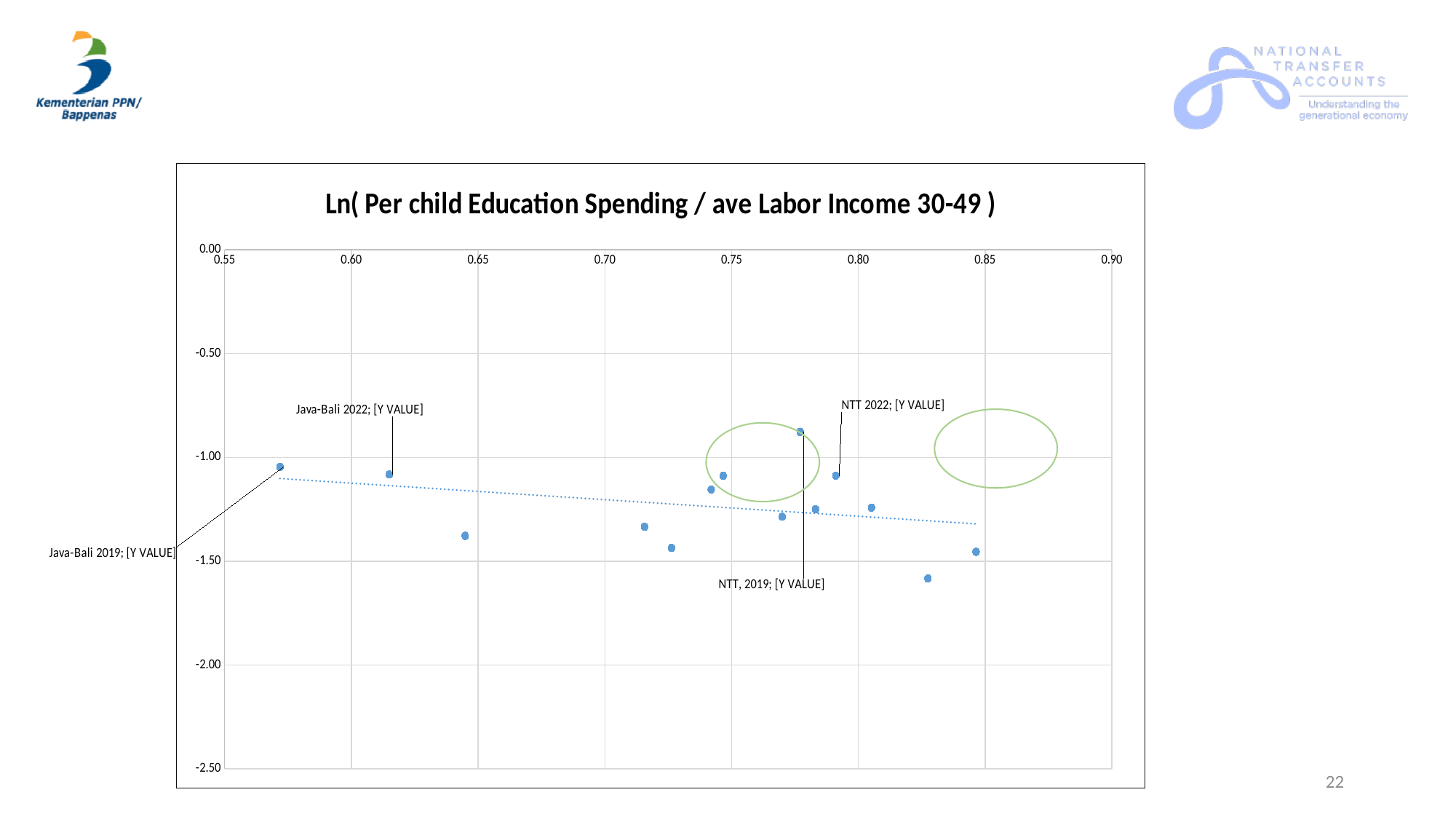
Is the y value for NTT 2019 greater or less than -1.00? greater What kind of chart is shown on the slide? Scatter chart Which has the higher y value, NTT 2019 or NTT 2022? NTT 2019 Is the y value for Java-Bali 2019 greater or less than -1.50? greater Which labeled point has the highest y value: Java-Bali 2019, Java-Bali 2022, NTT 2019 or NTT 2022? NTT 2019 How many data points are plotted on the chart? 14 Is the y value for NTT 2019 greater or less than -0.50? less What is the lowest value shown on the y-axis? -2.50 Does the dotted trend line rise or fall as the x-axis value increases? Fall What is the title of the chart? Ln( Per child Education Spending / ave Labor Income 30-49 ) Which has the higher y value, Java-Bali 2019 or NTT 2019? NTT 2019